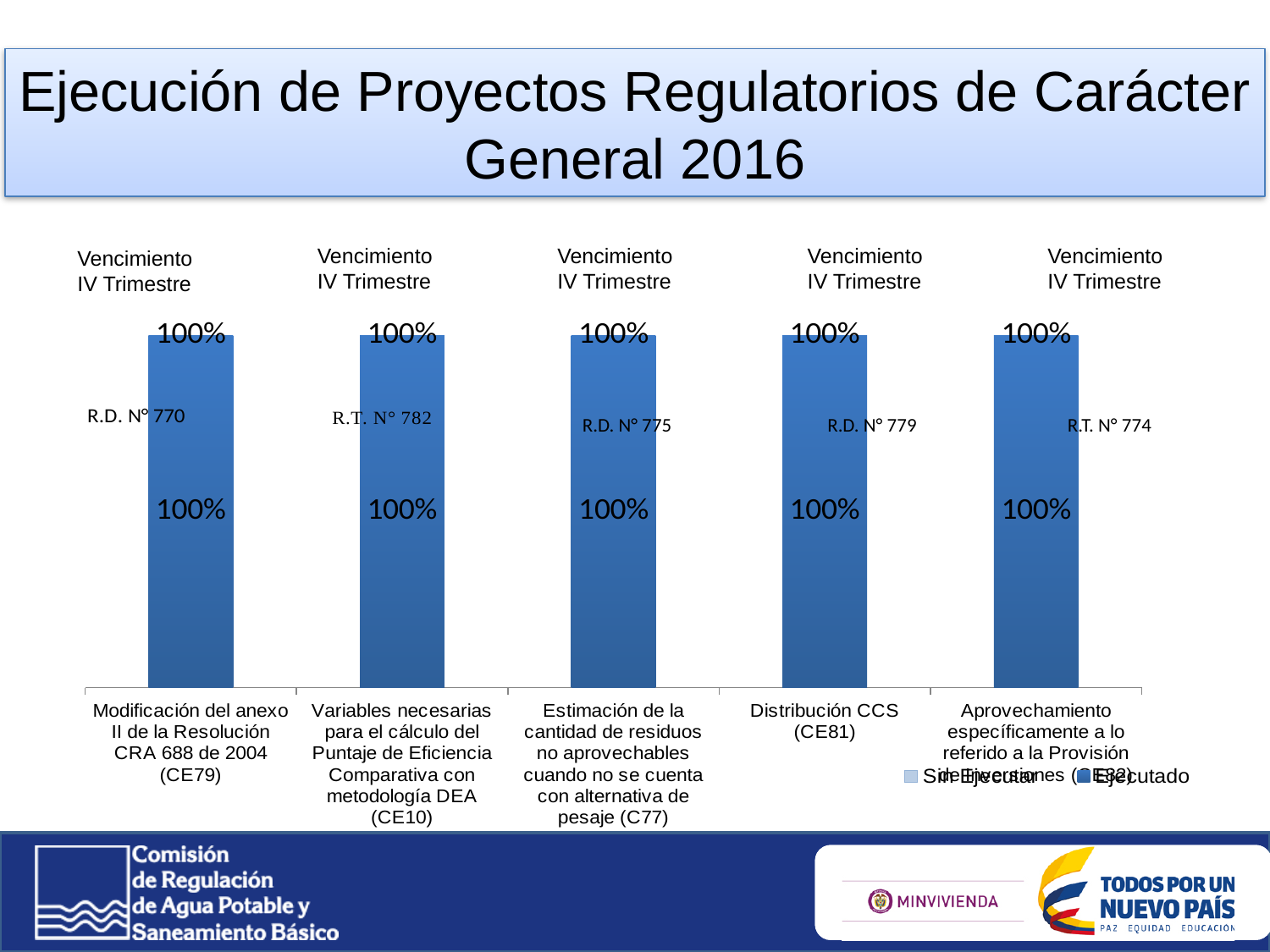
What is the value shown for Aprovechamiento específicamente a lo referido a la Provisión de Inversiones (CE82)? 100% What is the value shown for Modificación del anexo II de la Resolución CRA 688 de 2004 (CE79)? 100% What is the value shown for Estimación de la cantidad de residuos no aprovechables cuando no se cuenta con alternativa de pesaje (C77)? 100% How many categories are plotted in the chart? 5 What is the title of the slide containing the chart? Ejecución de Proyectos Regulatorios de Carácter General 2016 What kind of chart is shown on the slide? bar chart What is the value shown for Distribución CCS (CE81)? 100% Is the value for Variables necesarias para el cálculo del Puntaje de Eficiencia Comparativa con metodología DEA (CE10) greater or less than 50%? greater What deadline (vencimiento) is shown above each bar? IV Trimestre Do the values rise, fall, or stay the same across the categories from left to right? stay the same Which resolution number is written next to the bar for Distribución CCS (CE81)? R.D. N° 779